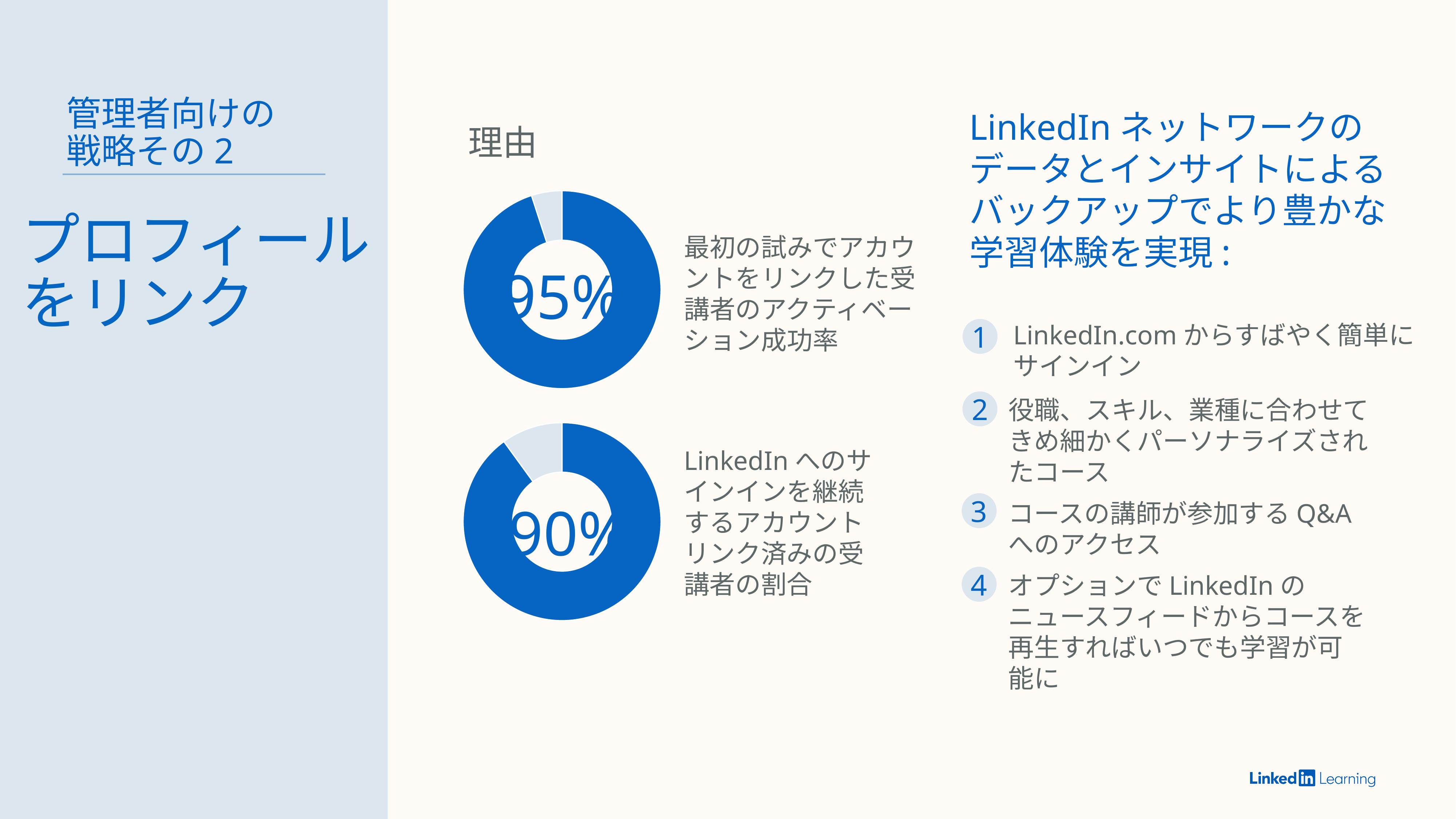
What colour is the large filled segment in both donut charts? Dark blue Which chart shows the larger value, the top donut chart or the bottom donut chart? The top donut chart In the top donut chart, what share of the ring is filled by the dark blue segment? 95% What percentage is given for the activation success rate of learners who linked their account on the first attempt (最初の試みでアカウントをリンクした受講者のアクティベーション成功率)? 95% How many donut charts are on the slide? 2 In the bottom donut chart, what share of the ring is filled by the dark blue segment? 90% What is the difference between the value in the top donut chart and the value in the bottom donut chart? 5% What value is shown in the centre of the bottom donut chart? 90% What heading appears above the two donut charts? 理由 What percentage is given for account-linked learners who continue signing in to LinkedIn (LinkedIn へのサインインを継続するアカウントリンク済みの受講者の割合)? 90% What value is shown in the centre of the top donut chart? 95% What kind of chart is used to display the 95% and 90% figures? Donut chart